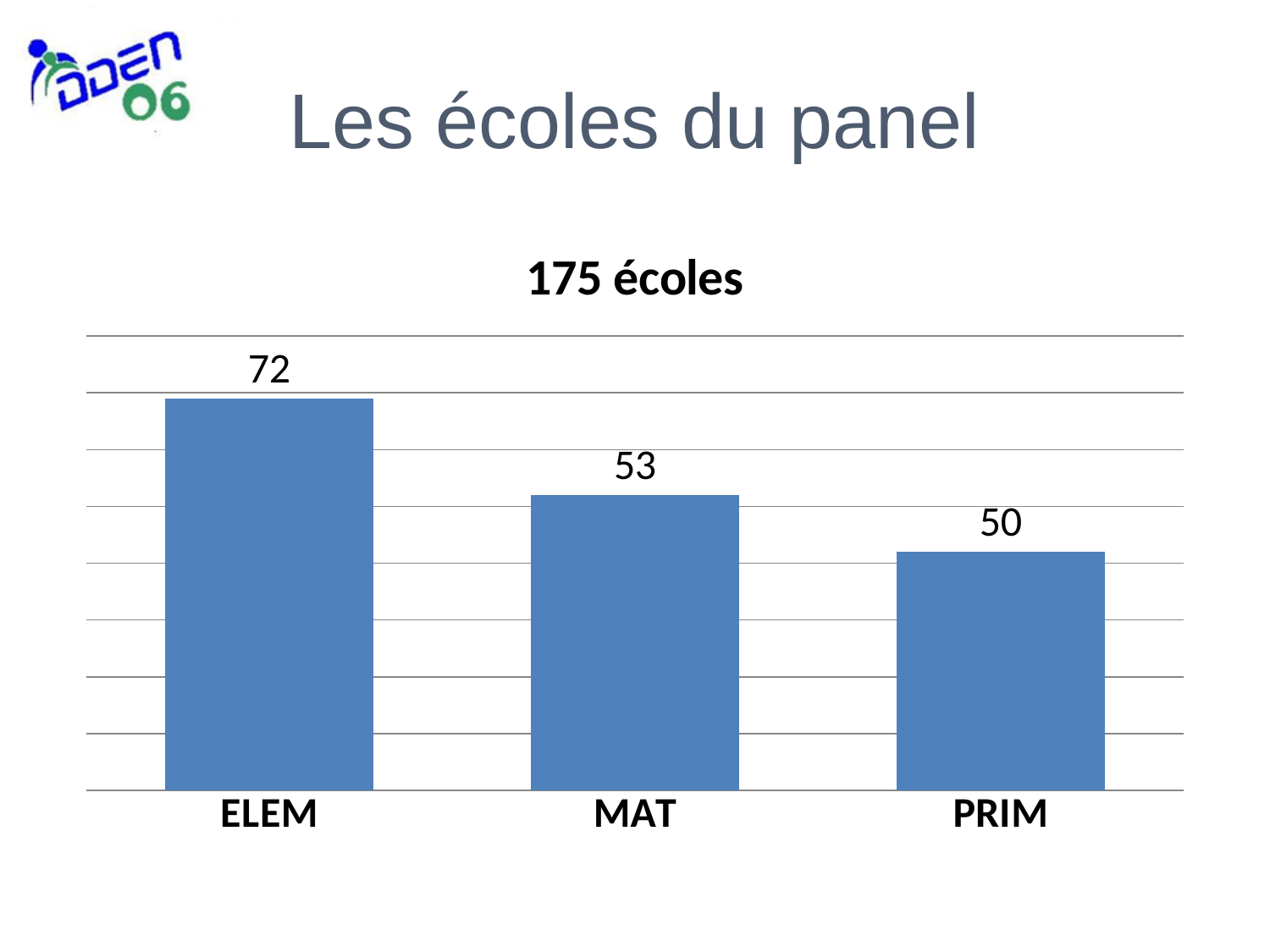
Which category has the lowest value? PRIM What is the difference between the values for MAT and PRIM? 3 Which category has the highest value? ELEM How many categories are shown in the chart? 3 What is the value for MAT? 53 What is the value for PRIM? 50 Do the values rise or fall from ELEM to PRIM along the x axis? fall What kind of chart is shown on the slide? bar chart Which is larger, the value for ELEM or the value for PRIM? ELEM What is the title of the chart? 175 écoles What is the value for ELEM? 72 What is the difference between the values for ELEM and MAT? 19